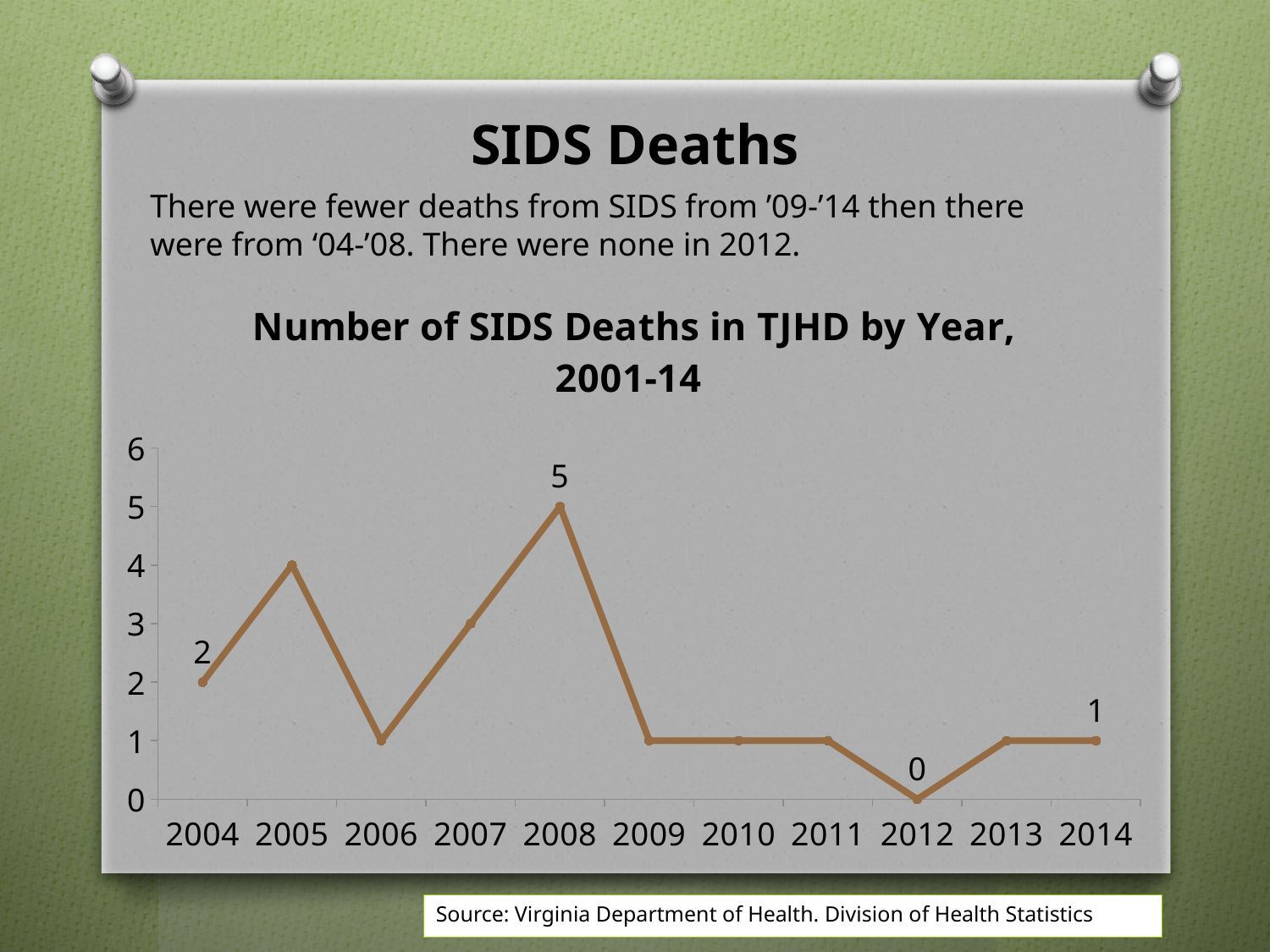
How many SIDS deaths were there in 2005? 4 What is the title of the chart? Number of SIDS Deaths in TJHD by Year, 2001-14 How many SIDS deaths were there in 2014? 1 What is the difference between the number of SIDS deaths in 2008 and in 2004? 3 How many SIDS deaths were there in 2012? 0 How many SIDS deaths were there in 2004? 2 Which year had more SIDS deaths, 2004 or 2014? 2004 Which year had the lowest number of SIDS deaths? 2012 Which year had the highest number of SIDS deaths? 2008 What kind of chart is shown on the slide? line chart How many years are plotted on the x axis of the chart? 11 How many SIDS deaths were there in 2008? 5